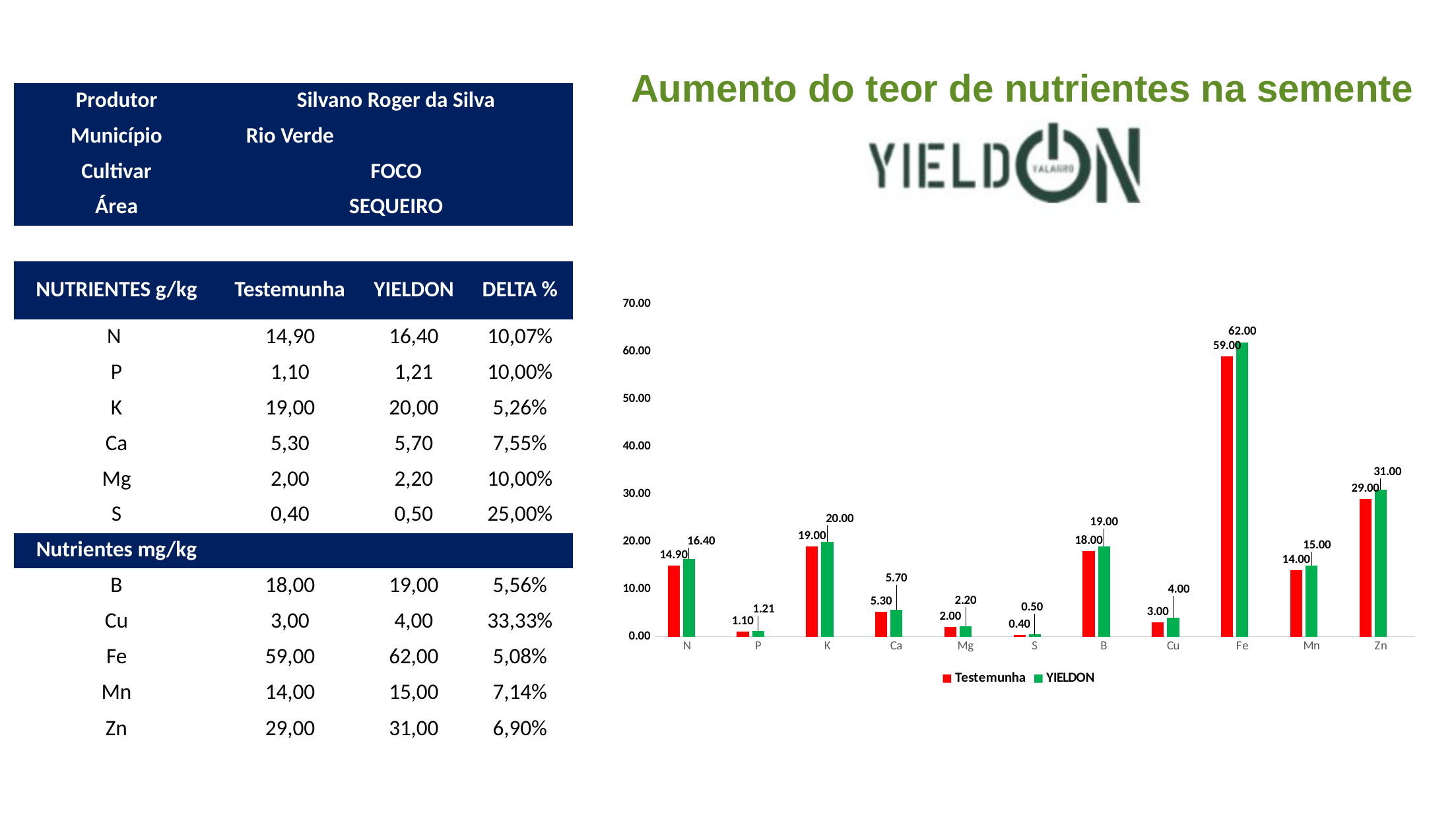
What is the YIELDON value for Zn in the chart? 31.00 Which category has the lowest Testemunha value in the chart? S How many categories are shown on the x axis of the chart? 11 What is the YIELDON value for N in the chart? 16.40 What is the difference between the YIELDON and Testemunha values for Fe in the chart? 3.00 How many series does the chart legend list? 2 What kind of chart is shown on the slide? Bar chart Is the YIELDON value for Zn greater or less than 30.00 in the chart? greater What is the difference between the YIELDON and Testemunha values for Cu in the chart? 1.00 What is the Testemunha value for Fe in the chart? 59.00 In the chart, which is larger: the Testemunha value for K or the Testemunha value for B? K Which category has the highest YIELDON value in the chart? Fe